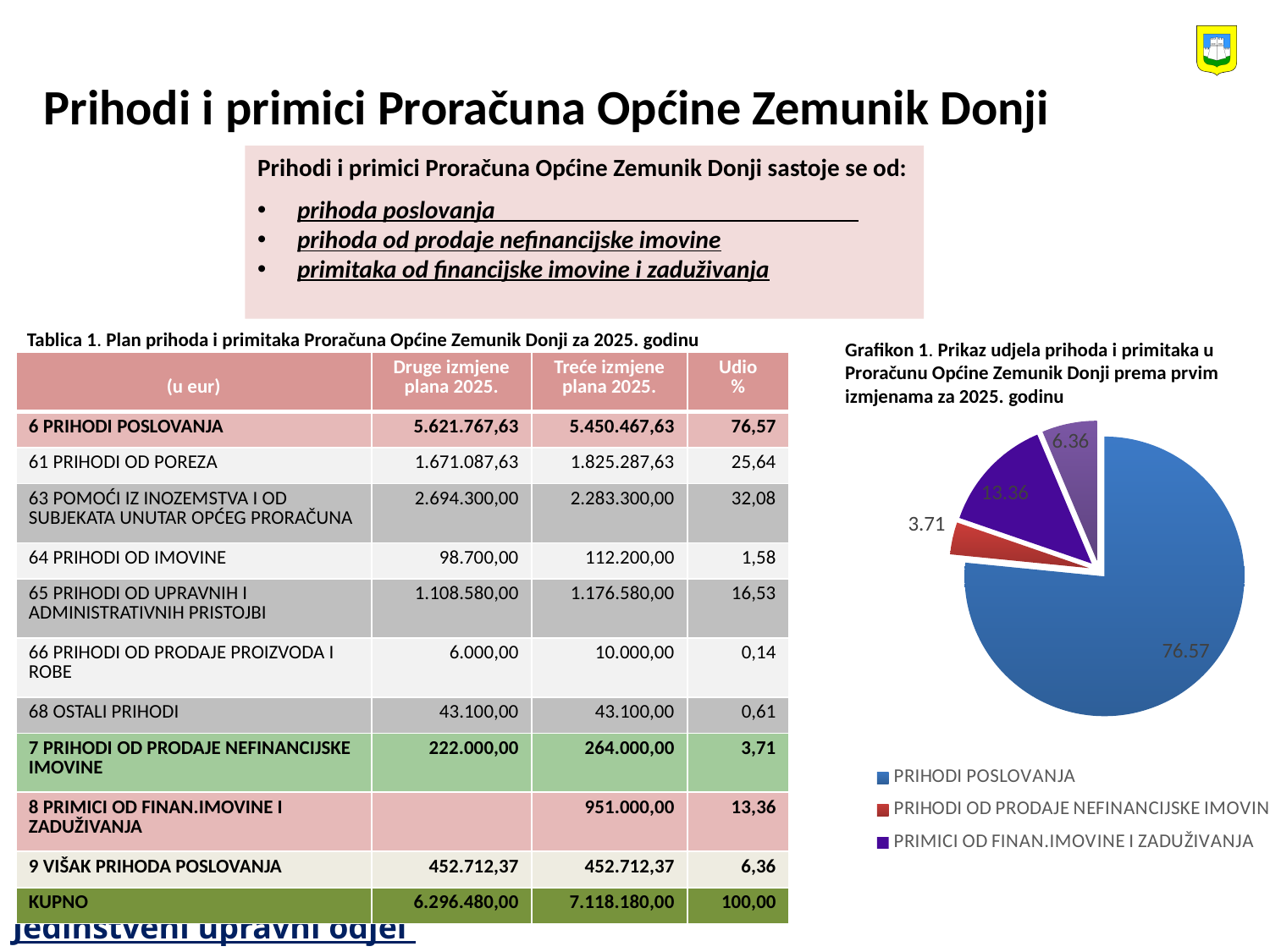
How many entries does the legend of the pie chart list? 3 How many slices does the pie chart have? 4 In the pie chart, what is the value shown for PRIMICI OD FINAN.IMOVINE I ZADUŽIVANJA? 13.36 What is the value label on the smallest slice of the pie chart? 3.71 In the pie chart, what is the value shown for PRIHODI POSLOVANJA? 76.57 Which slice of the pie chart is the largest? PRIHODI POSLOVANJA What colour is the PRIHODI POSLOVANJA slice in the pie chart? blue In the pie chart, which is larger: the slice for PRIMICI OD FINAN.IMOVINE I ZADUŽIVANJA or the slice labelled 6.36? PRIMICI OD FINAN.IMOVINE I ZADUŽIVANJA In the pie chart, what is the difference between the values for PRIHODI POSLOVANJA and PRIMICI OD FINAN.IMOVINE I ZADUŽIVANJA? 63.21 Which slice of the pie chart is the smallest? PRIHODI OD PRODAJE NEFINANCIJSKE IMOVINE What kind of chart is Grafikon 1 on the slide? pie chart In the pie chart, what is the value shown for PRIHODI OD PRODAJE NEFINANCIJSKE IMOVINE? 3.71